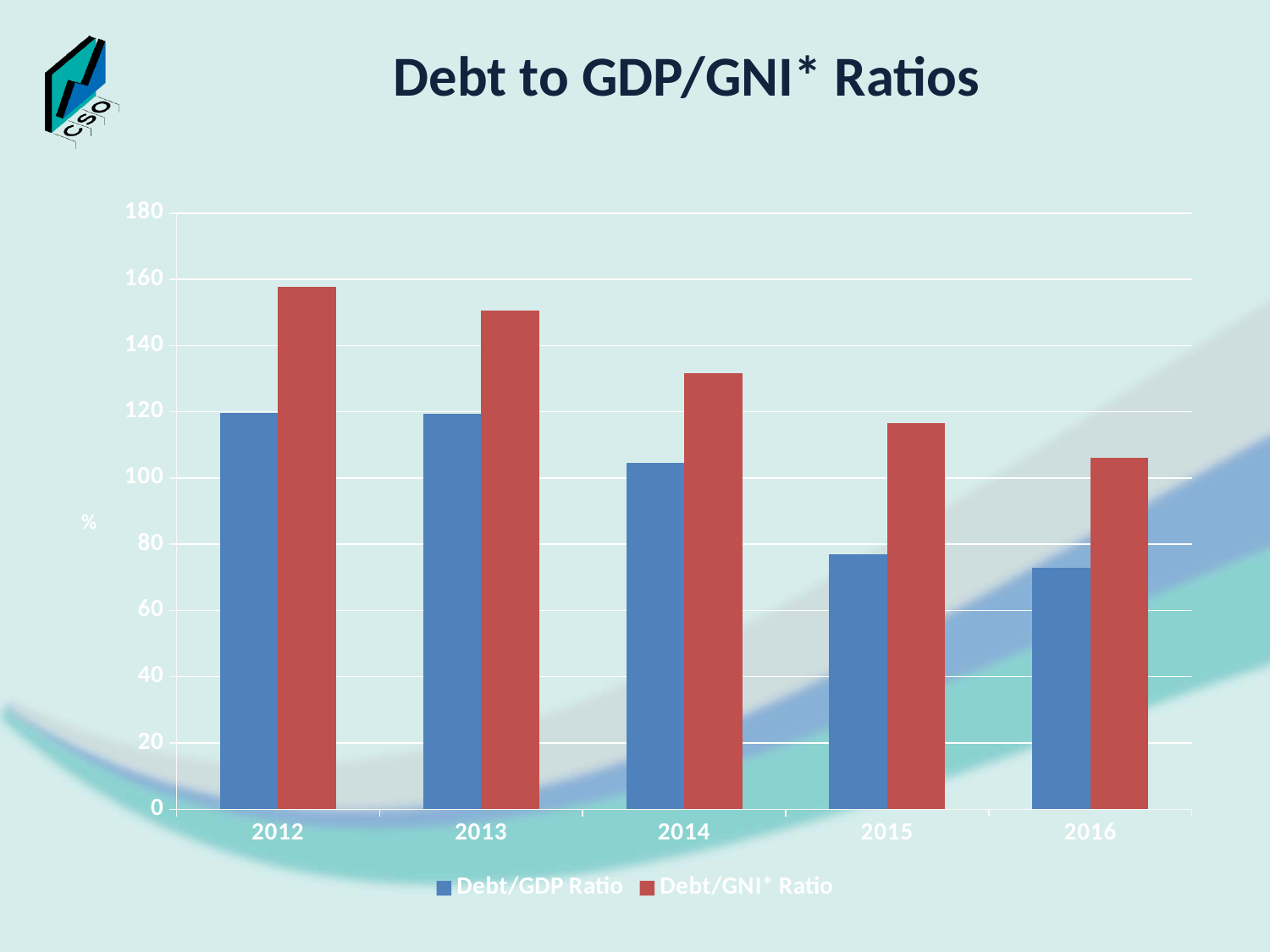
What kind of chart is shown on the slide? bar chart Is the Debt/GDP Ratio for 2014 greater or less than 120? less Is the Debt/GNI* Ratio for 2012 greater or less than 140? greater Which year has the lowest Debt/GNI* Ratio? 2016 How many years are shown on the x axis? 5 Is the Debt/GNI* Ratio for 2016 greater or less than 100? greater In 2014, which is larger: the Debt/GDP Ratio or the Debt/GNI* Ratio? Debt/GNI* Ratio Does the Debt/GNI* Ratio rise or fall from 2012 to 2016? fall Which year has the highest Debt/GNI* Ratio? 2012 How many series does the legend list? 2 What is the title of the chart? Debt to GDP/GNI* Ratios